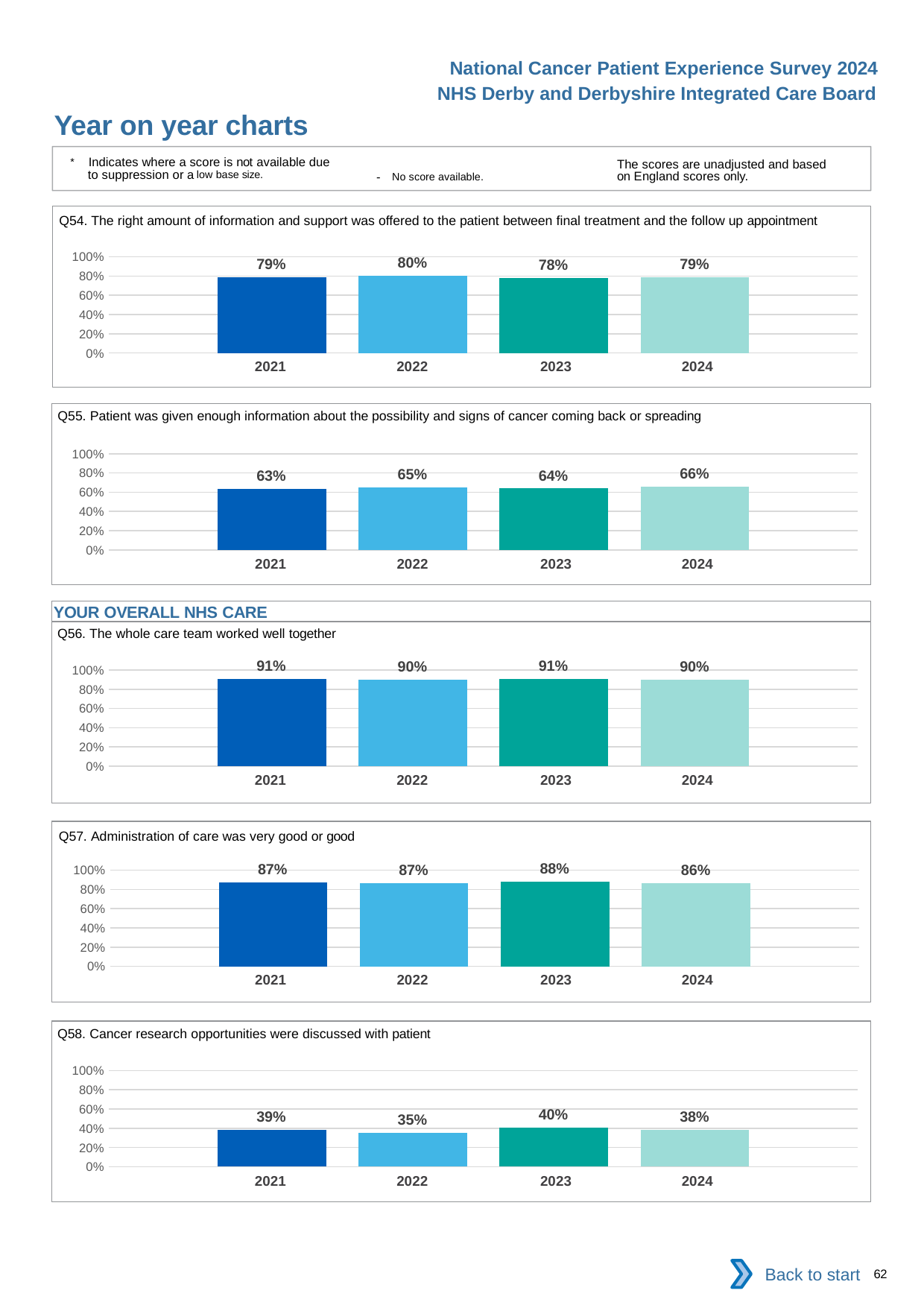
In the Q55 chart, which year has the lowest value? 2021 In the Q55 chart, what is the difference between the 2024 value and the 2021 value? 3% In the Q56 chart, what is the value for 2023? 91% In the Q55 chart, which year has the highest value? 2024 In the Q58 chart, is the value for 2021 greater or less than 60%? less What kind of chart is the Q57 chart? bar chart In the Q57 chart, what is the value for 2024? 86% How many years are shown in the Q56 chart? 4 In the Q54 chart, what is the value for 2022? 80% What is the section heading shown above the Q56 chart? YOUR OVERALL NHS CARE In the Q58 chart, which year has the lowest value? 2022 In the Q58 chart, what is the difference between the 2023 value and the 2022 value? 5%